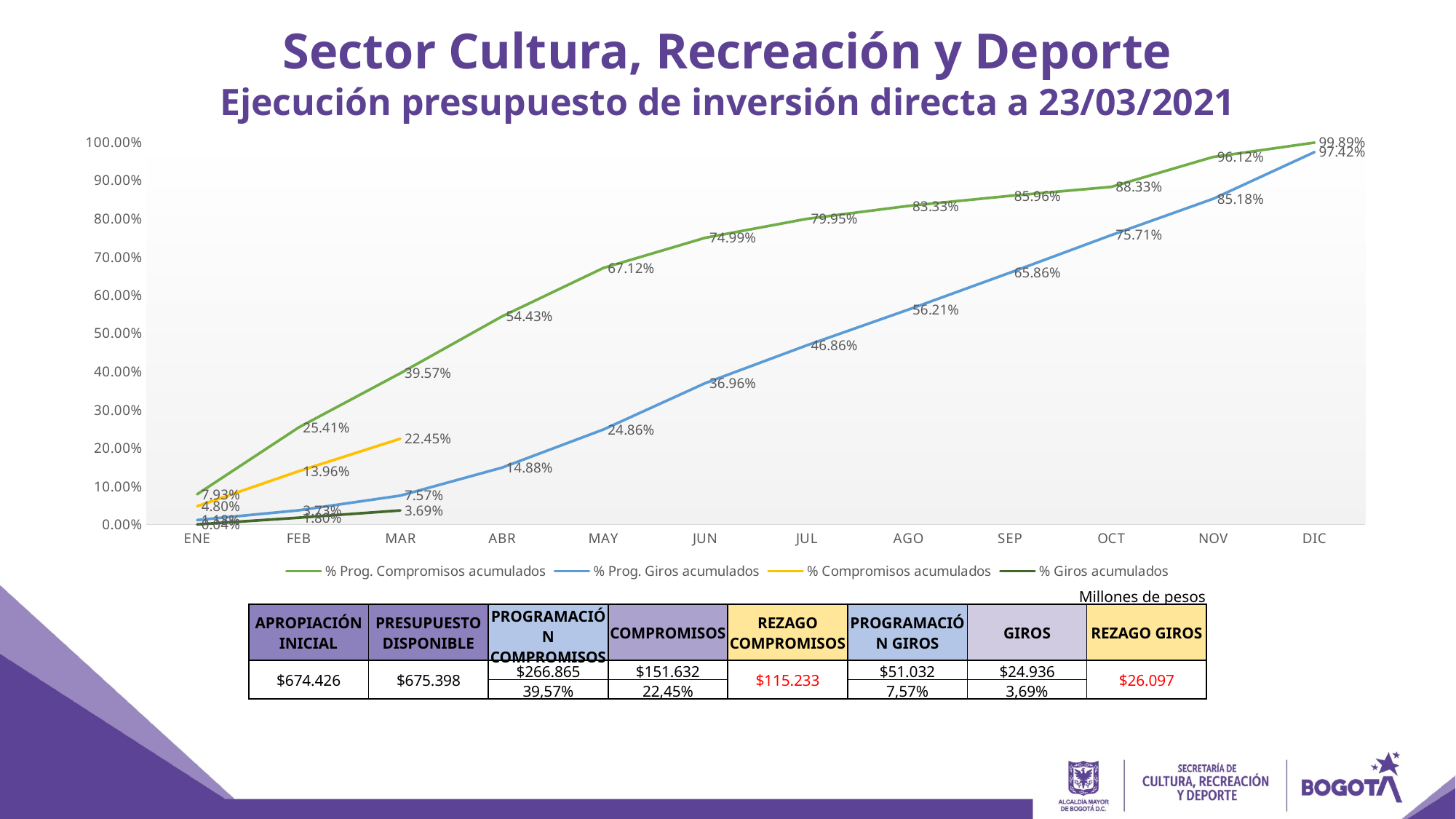
What is the value of % Compromisos acumulados in MAR? 22.45% In which month is % Prog. Compromisos acumulados lowest? ENE What kind of chart is shown on the slide? line chart What is the value of % Prog. Compromisos acumulados in DIC? 99.89% What is the value of % Giros acumulados in MAR? 3.69% How many months are shown on the x axis of the chart? 12 How many series does the chart legend list? 4 What is the value of % Prog. Giros acumulados in JUN? 36.96% Which series in the chart is drawn in yellow? % Compromisos acumulados Does % Prog. Giros acumulados rise or fall from ENE to DIC? rise Which is larger in FEB: % Compromisos acumulados or % Prog. Giros acumulados? % Compromisos acumulados What is the difference between % Prog. Compromisos acumulados and % Prog. Giros acumulados in MAR? 32.00%